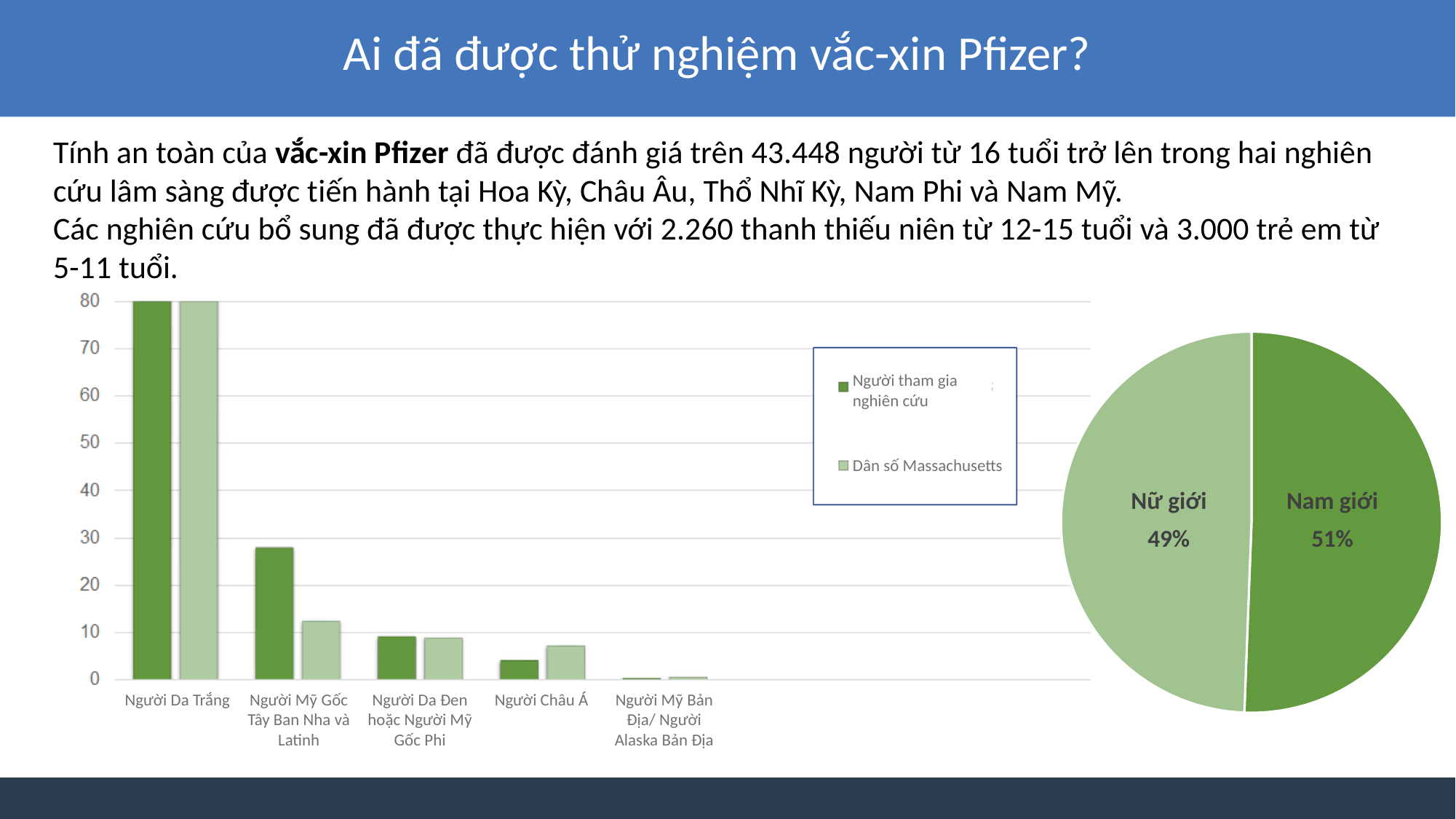
How many series does the legend of the bar chart on the left list? 2 In the bar chart on the left, is the value for Dân số Massachusetts in the category Người Mỹ Gốc Tây Ban Nha và Latinh greater or less than 20? less In the pie chart on the right, which slice is larger, Nữ giới or Nam giới? Nam giới How many categories are shown on the x axis of the bar chart on the left? 5 In the bar chart on the left, is the value for Người tham gia nghiên cứu in the category Người Mỹ Gốc Tây Ban Nha và Latinh greater or less than 20? greater How many slices does the pie chart on the right have? 2 What kind of chart is the chart on the left of the slide? Bar chart In the pie chart on the right, what share is shown for Nữ giới? 49% In the pie chart on the right, what share is shown for Nam giới? 51% In the bar chart on the left, do the values for Người tham gia nghiên cứu rise or fall from left to right along the x axis? fall In the bar chart on the left, for the category Người Châu Á, which series has the larger value? Dân số Massachusetts In the bar chart on the left, which category has the highest value for Người tham gia nghiên cứu? Người Da Trắng